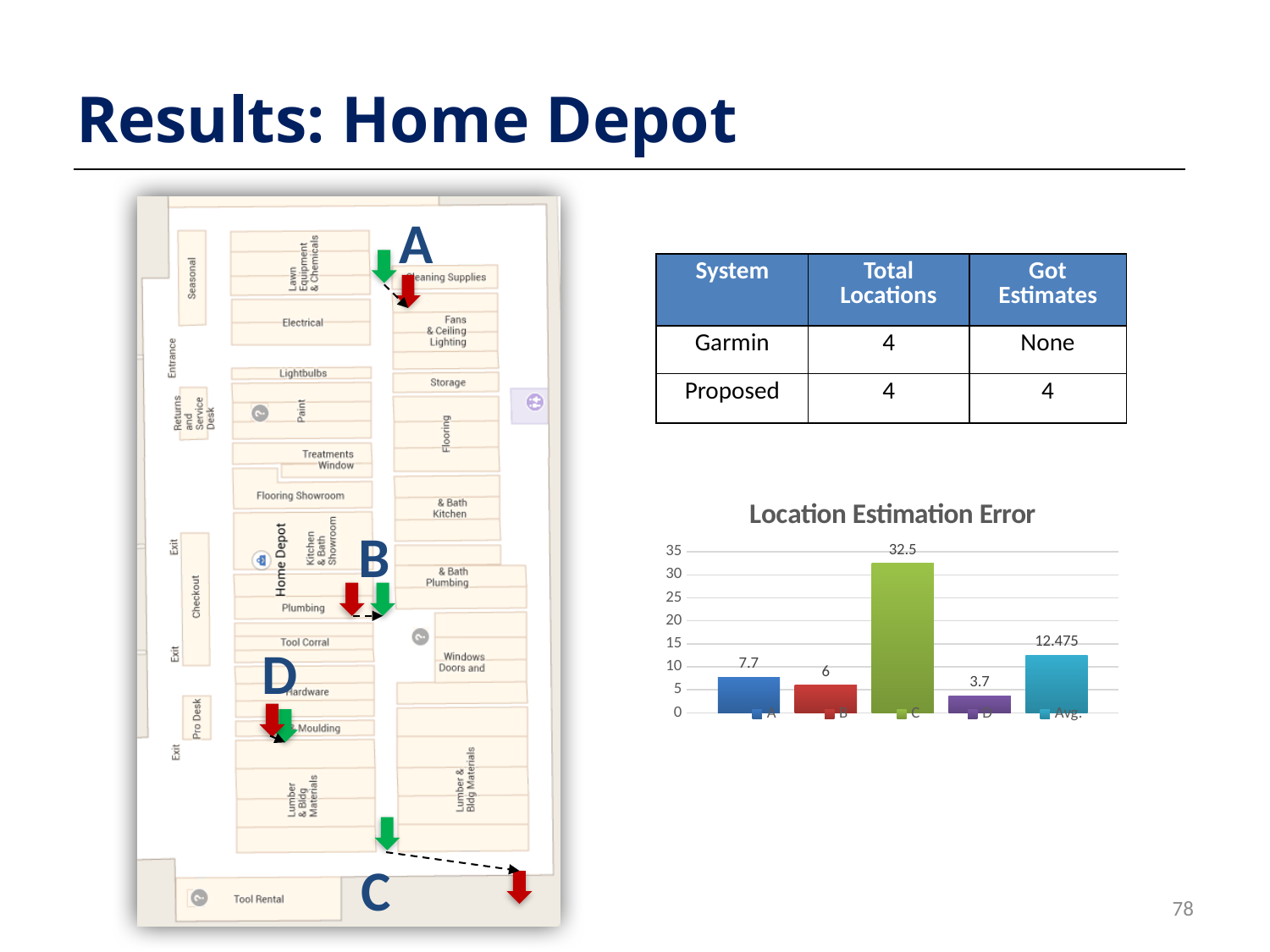
What is the value for C in the Location Estimation Error chart? 32.5 What is the value for Avg. in the Location Estimation Error chart? 12.475 What is the difference between the values for A and B in the Location Estimation Error chart? 1.7 Which category has the lowest value in the Location Estimation Error chart? D In the Location Estimation Error chart, which is larger, the value for A or the value for B? A What kind of chart is the Location Estimation Error chart? Bar chart What is the difference between the values for C and D in the Location Estimation Error chart? 28.8 How many bars are plotted in the Location Estimation Error chart? 5 What is the value for A in the Location Estimation Error chart? 7.7 Which category has the highest value in the Location Estimation Error chart? C Is the value for C in the Location Estimation Error chart greater or less than 30? greater What is the value for D in the Location Estimation Error chart? 3.7